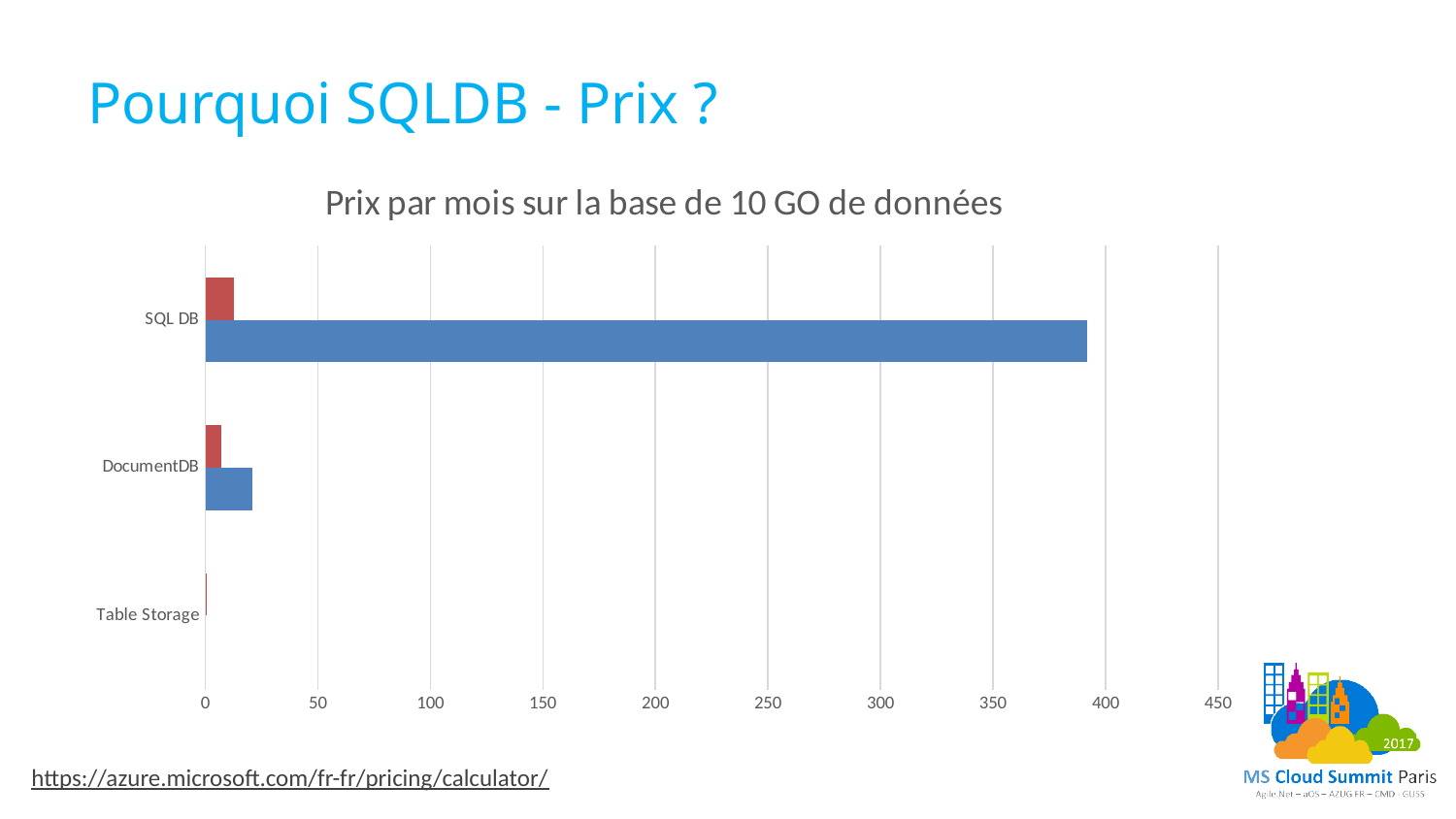
Is the value of the blue bar for SQL DB greater or less than 350? greater What is the highest value labelled on the horizontal axis of the chart? 450 Is the value of the red bar for SQL DB greater or less than 50? less What kind of chart is shown on the slide? bar chart Which category has the longest bar in the chart? SQL DB How many categories are shown on the vertical axis of the chart? 3 Is the value of the blue bar for SQL DB greater or less than 400? less Which is larger, the blue bar for SQL DB or the blue bar for DocumentDB? SQL DB Which category has the shortest bars in the chart? Table Storage What is the title of the chart? Prix par mois sur la base de 10 GO de données Which is larger, the red bar for SQL DB or the red bar for Table Storage? SQL DB